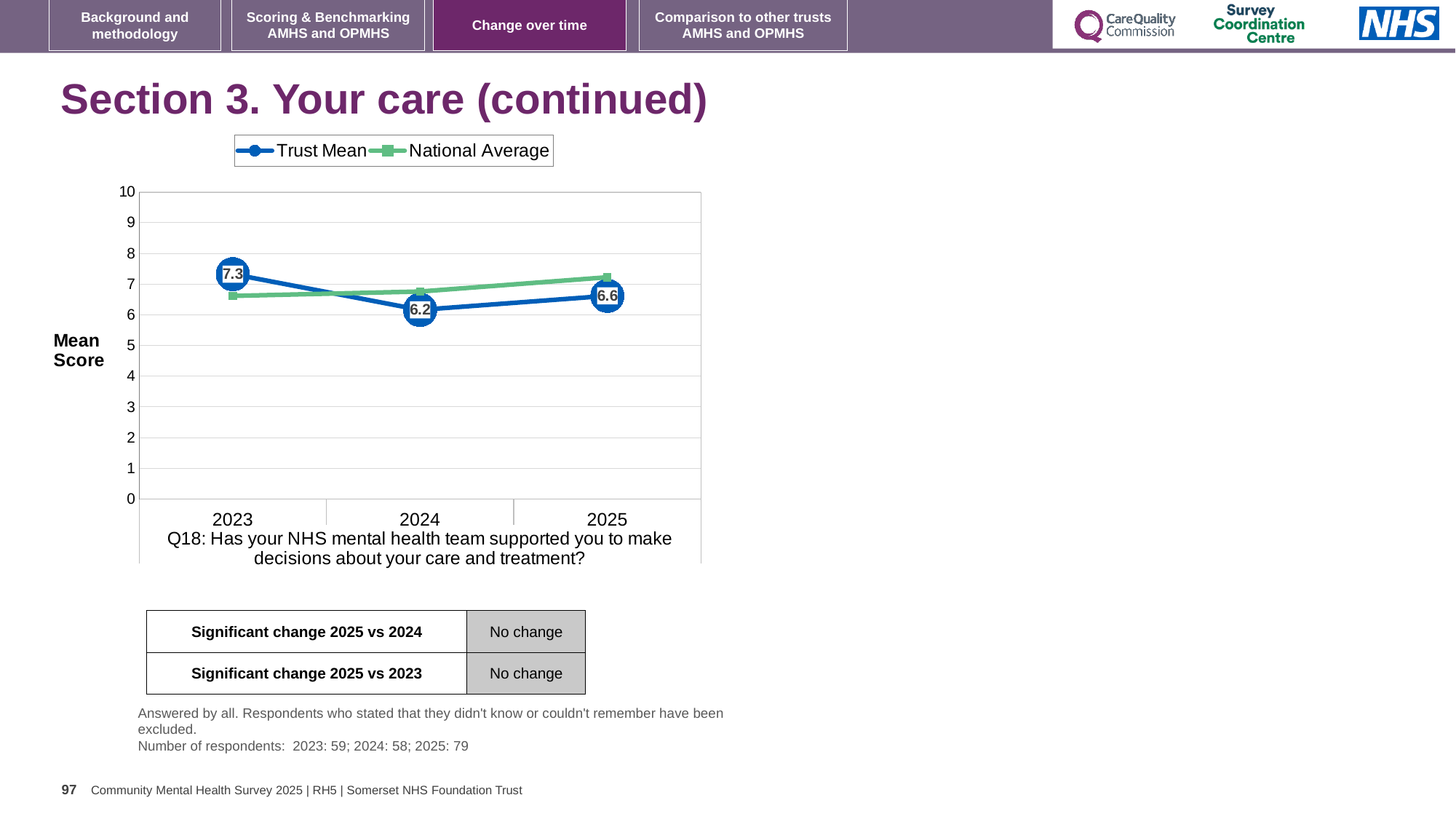
Is the National Average for 2023 greater or less than 7? less What is the difference between the Trust Mean in 2023 and in 2024? 1.1 How many series does the legend list? 2 Does the Trust Mean rise or fall from 2023 to 2024? fall In which year is the Trust Mean highest? 2023 What is the Trust Mean score for 2024? 6.2 In 2025, which is higher: the Trust Mean or the National Average? National Average In which year is the Trust Mean lowest? 2024 What kind of chart is shown on the slide? line chart How many years are plotted on the x axis? 3 What is the Trust Mean score for 2025? 6.6 What is the Trust Mean score for 2023? 7.3